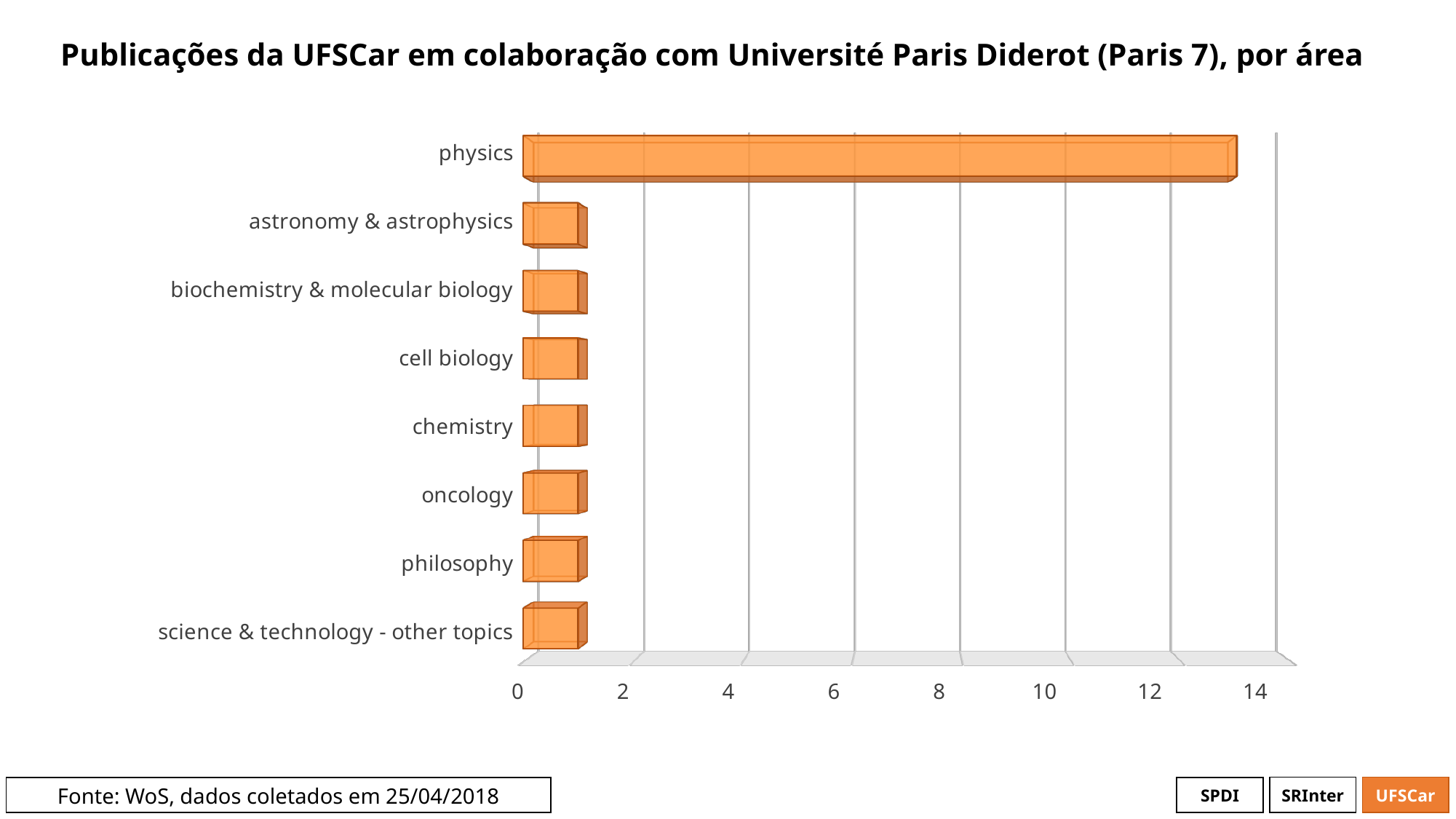
How many research areas are listed on the chart? 8 Which area has the highest number of publications? physics What is the highest value shown on the horizontal axis? 14 Is the value for astronomy & astrophysics greater or less than 2? less Which has more publications, cell biology or physics? physics What kind of chart is shown on the slide? bar chart Which area is listed at the bottom of the chart? science & technology - other topics Which has more publications, physics or oncology? physics What is the title of the chart? Publicações da UFSCar em colaboração com Université Paris Diderot (Paris 7), por área Is the value for physics greater or less than 12? greater Is the value for chemistry greater or less than 2? less